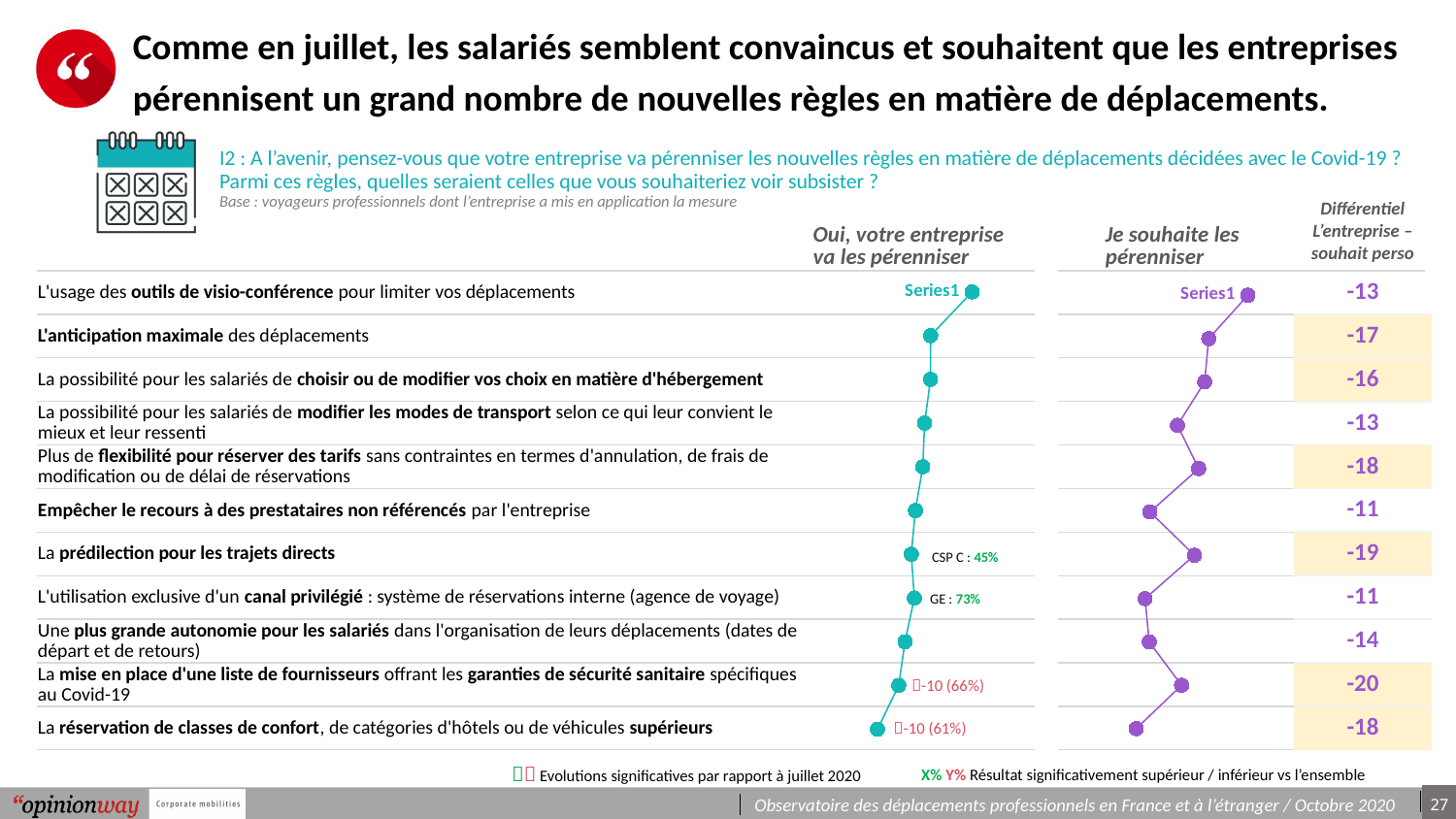
In the "Je souhaite les pérenniser" chart, which is larger: the value for "L'usage des outils de visio-conférence" or for "Empêcher le recours à des prestataires non référencés"? L'usage des outils de visio-conférence In the "Oui, votre entreprise va les pérenniser" chart, which rule has the highest value? L'usage des outils de visio-conférence pour limiter vos déplacements What is the series label shown on the "Oui, votre entreprise va les pérenniser" chart? Series1 In the "Je souhaite les pérenniser" chart, which rule has the highest value? L'usage des outils de visio-conférence pour limiter vos déplacements How many series does the "Je souhaite les pérenniser" chart show? 1 What colour are the points and line in the "Je souhaite les pérenniser" chart? purple What is the "Différentiel" value shown for "La mise en place d'une liste de fournisseurs offrant les garanties de sécurité sanitaire spécifiques au Covid-19"? -20 How many categories (rules) are plotted in the "Oui, votre entreprise va les pérenniser" chart? 11 In the "Oui, votre entreprise va les pérenniser" chart, which rule has the lowest value? La réservation de classes de confort, de catégories d'hôtels ou de véhicules supérieurs In the "Oui, votre entreprise va les pérenniser" chart, do the values rise or fall going from the top rule to the bottom rule? fall What kind of chart is used under the heading "Oui, votre entreprise va les pérenniser"? line chart In the "Oui, votre entreprise va les pérenniser" chart, which is larger: the value for "L'anticipation maximale des déplacements" or for "La réservation de classes de confort"? L'anticipation maximale des déplacements